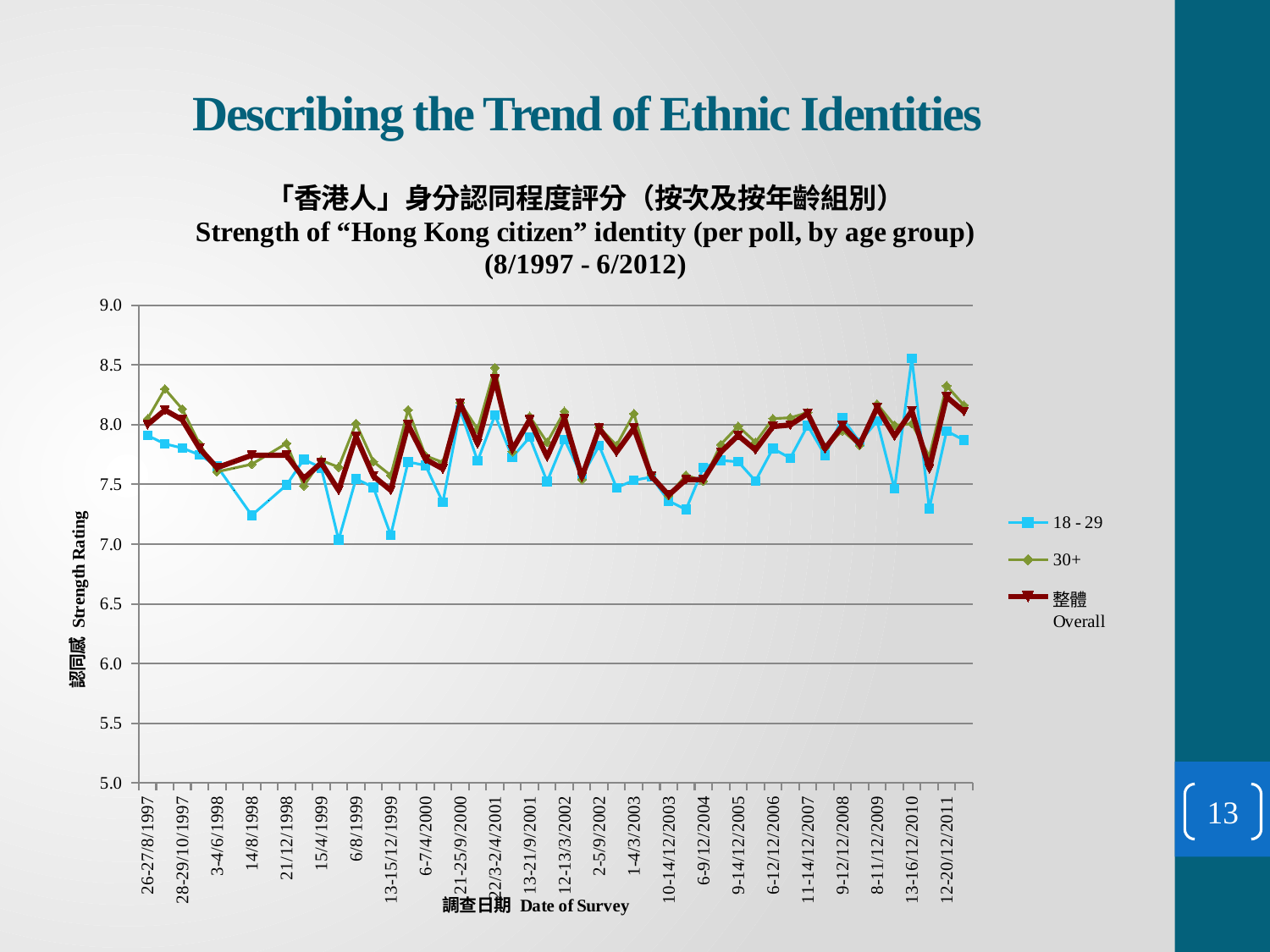
Is the value for the Overall series at 22/3-2/4/2001 greater or less than 8.0? greater What is the label of the vertical axis (in English)? Strength Rating At which survey date does the 18 - 29 series reach its highest value? 13-16/12/2010 At 14/8/1998, which series is higher: 18 - 29 or Overall? Overall Is the value for the 18 - 29 series at 13-16/12/2010 greater or less than 8.0? greater What is the highest value shown on the vertical axis? 9.0 Which series has the highest value at 13-16/12/2010? 18 - 29 What kind of chart is shown on the slide? line chart How many series does the legend list? 3 At 6/8/1999, which series is higher: 30+ or 18 - 29? 30+ Is the value for the 18 - 29 series at 14/8/1998 greater or less than 7.5? less